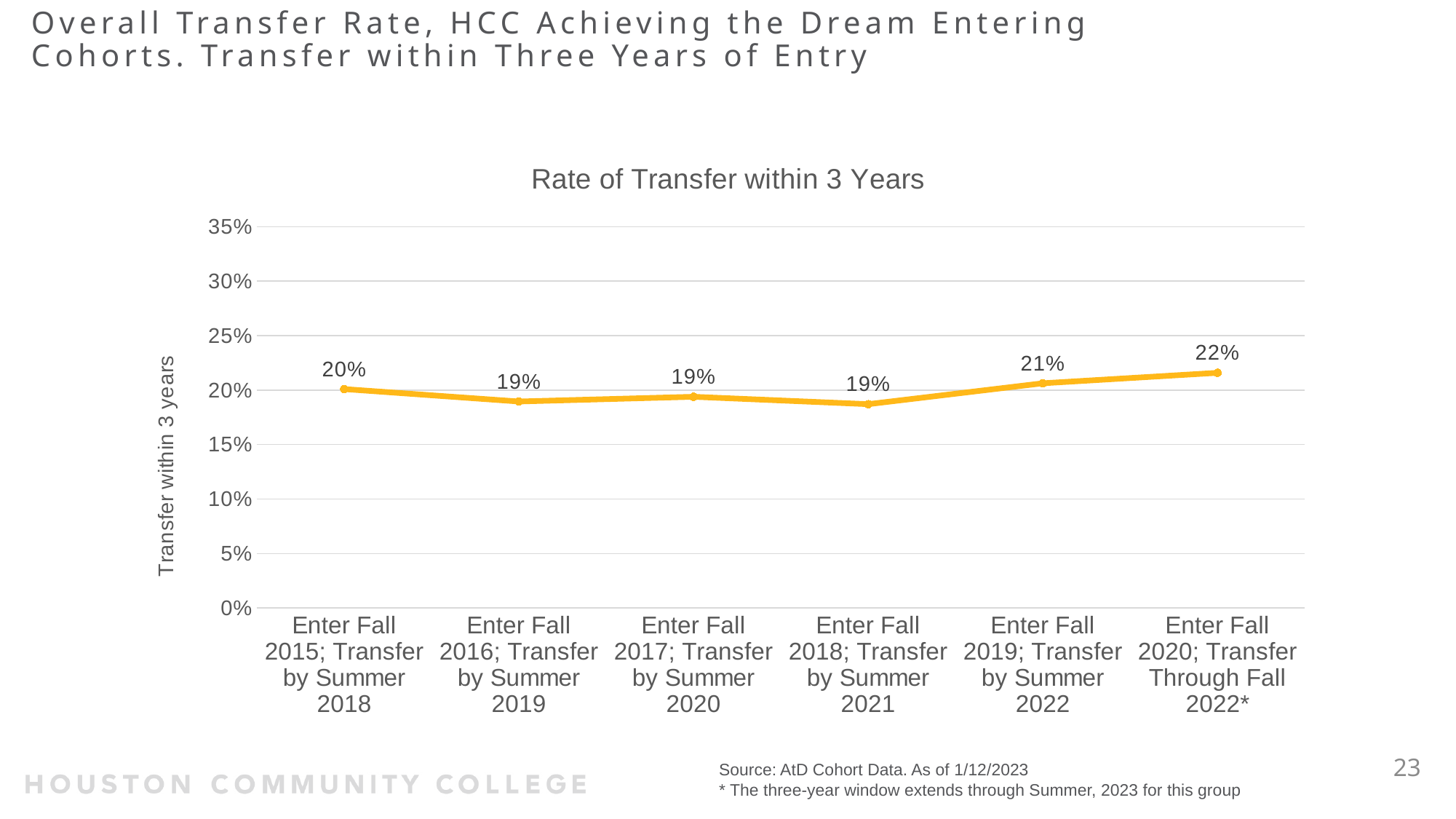
Which cohort has a higher transfer rate, Enter Fall 2016 or Enter Fall 2019? Enter Fall 2019 What is the transfer rate for the Enter Fall 2019 cohort? 21% How many entering cohorts are plotted on the chart? 6 What is the difference in transfer rate between the Enter Fall 2020 cohort and the Enter Fall 2015 cohort? 2 percentage points What is the transfer rate for the Enter Fall 2020 cohort? 22% What is the title of the chart? Rate of Transfer within 3 Years Which entering cohort has the highest transfer rate within 3 years? Enter Fall 2020 Is the transfer rate for the Enter Fall 2020 cohort greater or less than 25%? less What is the transfer rate for the Enter Fall 2018 cohort? 19% What is the transfer rate for the Enter Fall 2015 cohort? 20% What kind of chart is shown on the slide? line chart Does the transfer rate rise or fall from the Enter Fall 2018 cohort to the Enter Fall 2020 cohort? rise